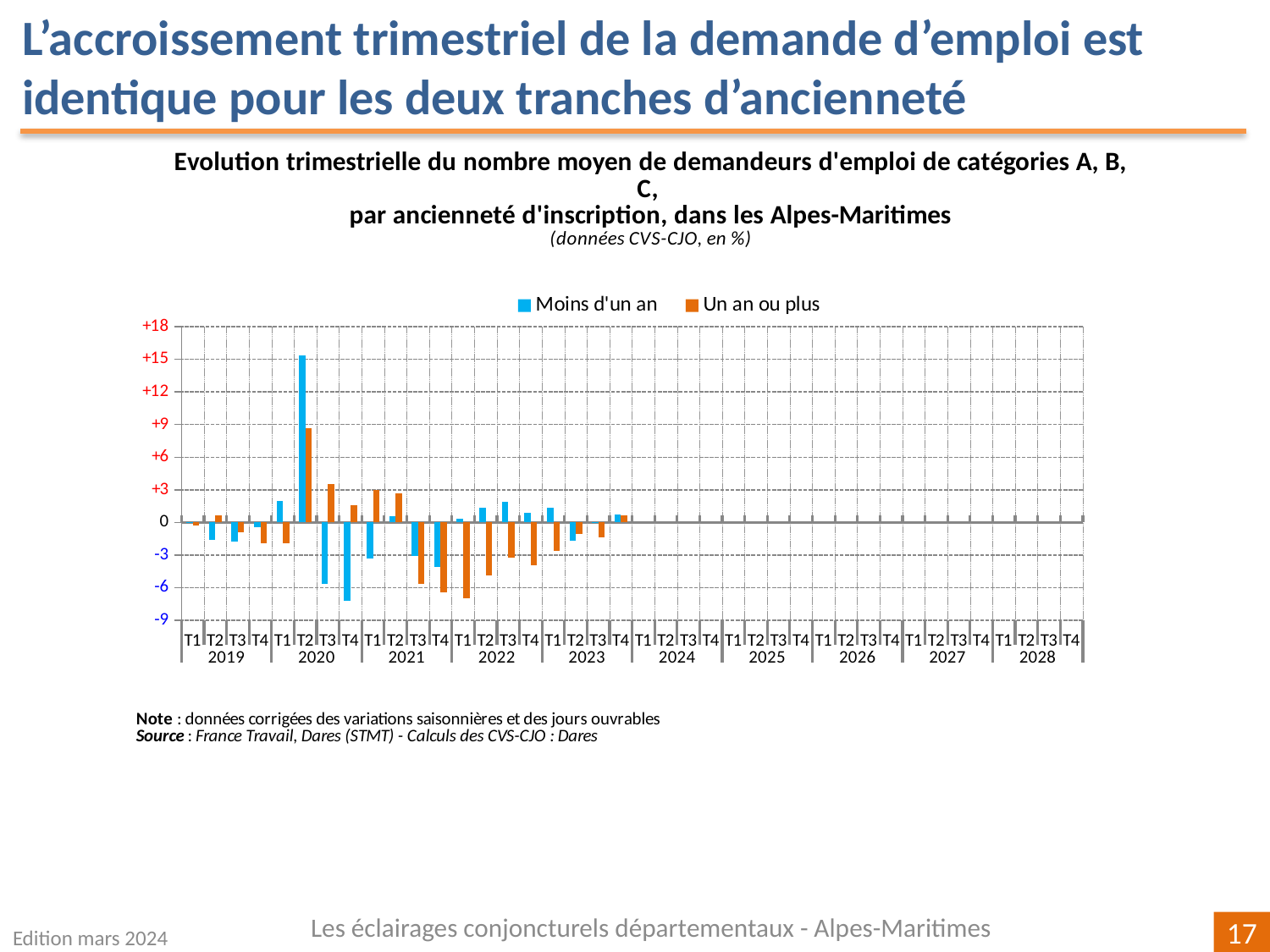
In which quarter does the series 'Moins d'un an' reach its lowest value? T4 2020 What kind of chart is shown on the slide? Bar chart What are the two series named in the legend? Moins d'un an; Un an ou plus In T1 2021, which series has the larger value, 'Moins d'un an' or 'Un an ou plus'? Un an ou plus Is the value for 'Moins d'un an' in T2 2020 greater or less than +12? greater How many series does the legend list? 2 Is the value for 'Un an ou plus' in T1 2022 greater or less than -6? less Which colour represents the series 'Un an ou plus'? Orange In which quarter does the series 'Moins d'un an' reach its highest value? T2 2020 Is the value for 'Moins d'un an' in T4 2020 greater or less than -6? less In T2 2020, which series has the larger value, 'Moins d'un an' or 'Un an ou plus'? Moins d'un an